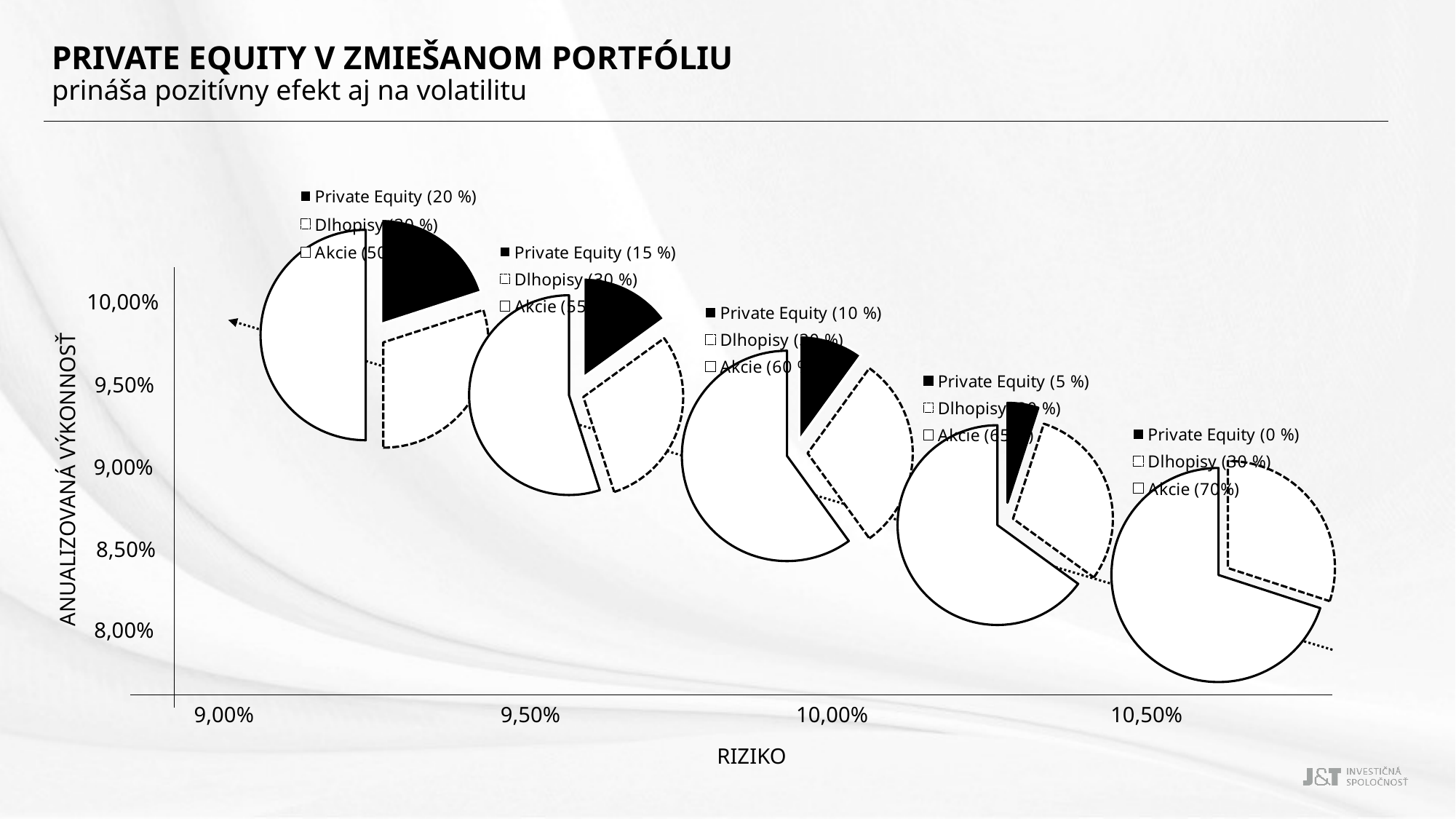
What share of the leftmost pie chart is Private Equity? 20 % How many pie charts are plotted on the slide? 5 How many entries does the legend of each pie chart list? 3 Which pie chart has the smallest Private Equity share? Private Equity (0 %) What is the label of the x axis? RIZIKO What share of the rightmost pie chart is Dlhopisy? 30 % What is the Private Equity share in the middle (third) pie chart? 10 % Which pie chart has the largest Private Equity share? Private Equity (20 %) Is the annualized performance of the portfolio with Private Equity (20 %) greater or less than 9,00%? greater As risk (RIZIKO) increases along the x axis, does the annualized performance of the portfolios rise or fall? Fall What kind of chart is used to show each portfolio composition on the slide? Pie chart